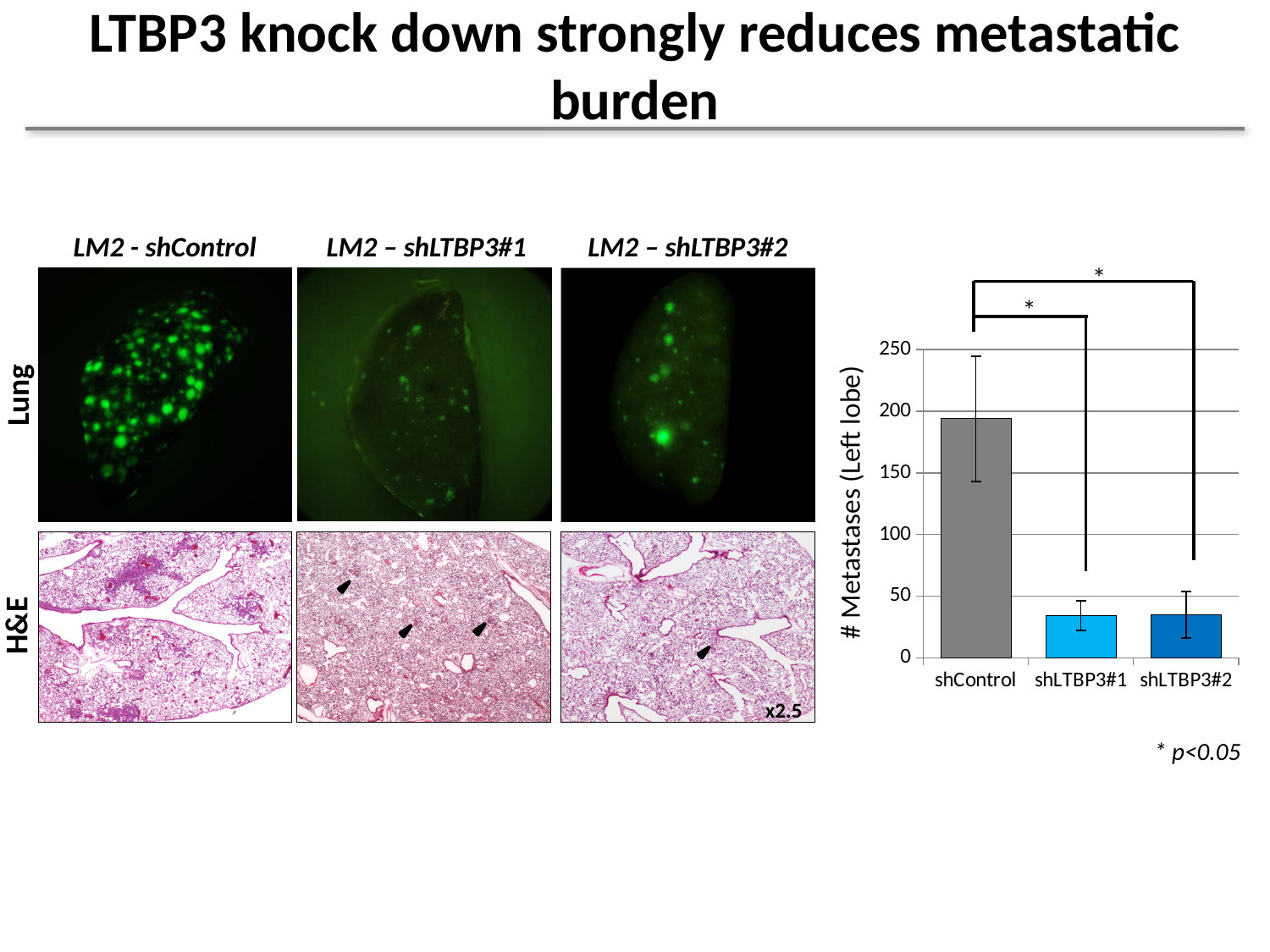
How many categories are plotted on the x axis of the bar chart? 3 What is the label of the y axis of the bar chart? # Metastases (Left lobe) Which is larger, the value for shControl or the value for shLTBP3#2? shControl Is the value for shControl greater or less than 150? greater What kind of chart is shown on the right side of the slide? bar chart Is the value for shLTBP3#2 greater or less than 100? less Is the value for shControl greater or less than 250? less Which category has the highest number of metastases in the bar chart? shControl What is the highest tick value shown on the y axis of the bar chart? 250